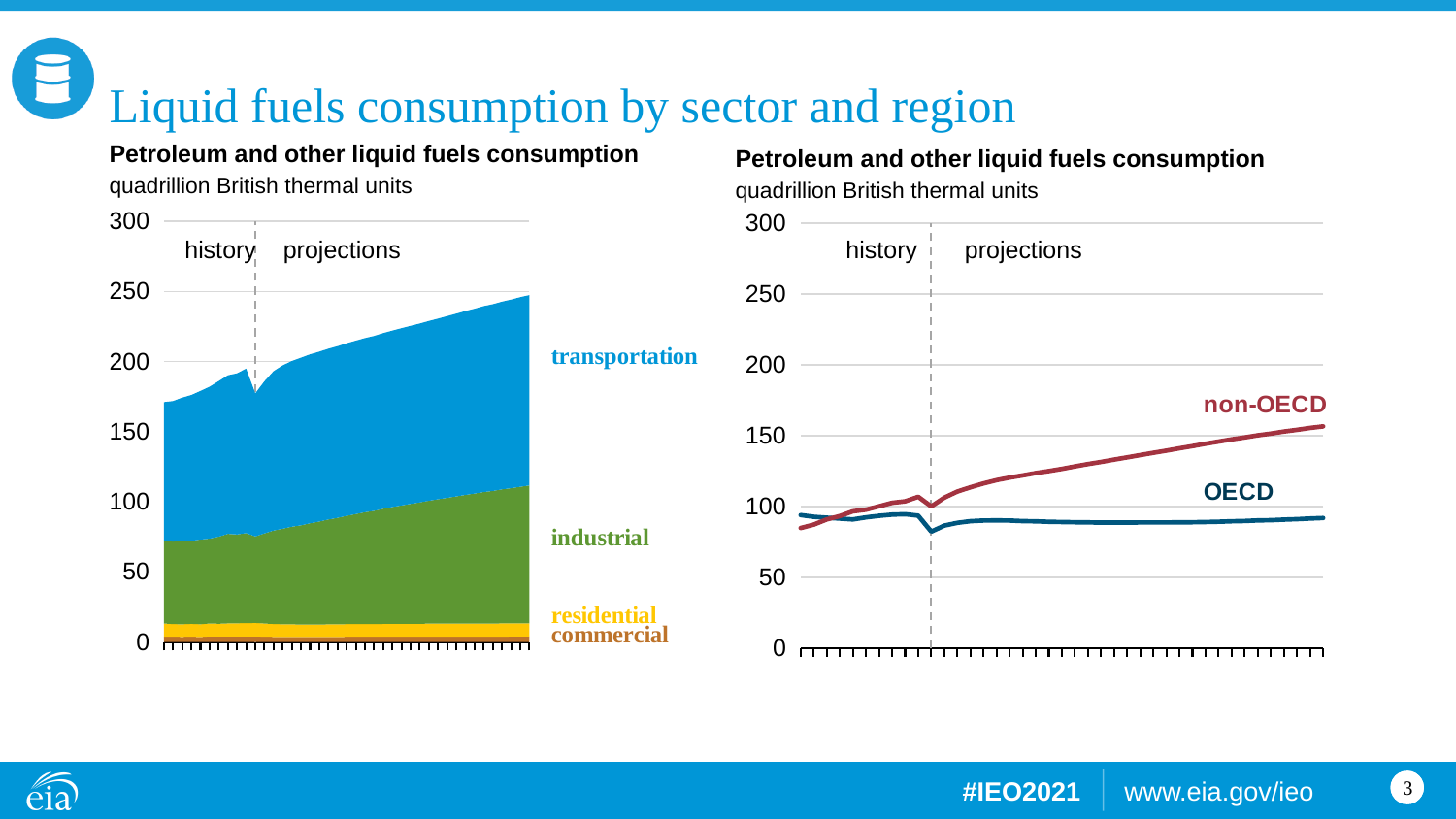
In the right-hand chart, is the non-OECD value at the end of the projection period greater or less than 100? greater In the right-hand chart, how many series are plotted? 2 In the right-hand chart, is the OECD value at the end of the projection period greater or less than 100? less What do the two labels above the dashed vertical line in each chart say? history and projections In the right-hand chart, does the non-OECD line rise or fall over the projection period? rises In the right-hand chart, which series is higher at the end of the projection period, non-OECD or OECD? non-OECD What kind of chart is the left-hand chart on the slide? stacked area chart What kind of chart is the right-hand chart on the slide? line chart In the left-hand chart, which sector accounts for the largest share of consumption at the end of the projection period? transportation What unit is used on the y axis of both charts? quadrillion British thermal units In the left-hand chart, is the total consumption at the end of the projection period greater or less than 200? greater In the left-hand chart, how many sectors are stacked? 4